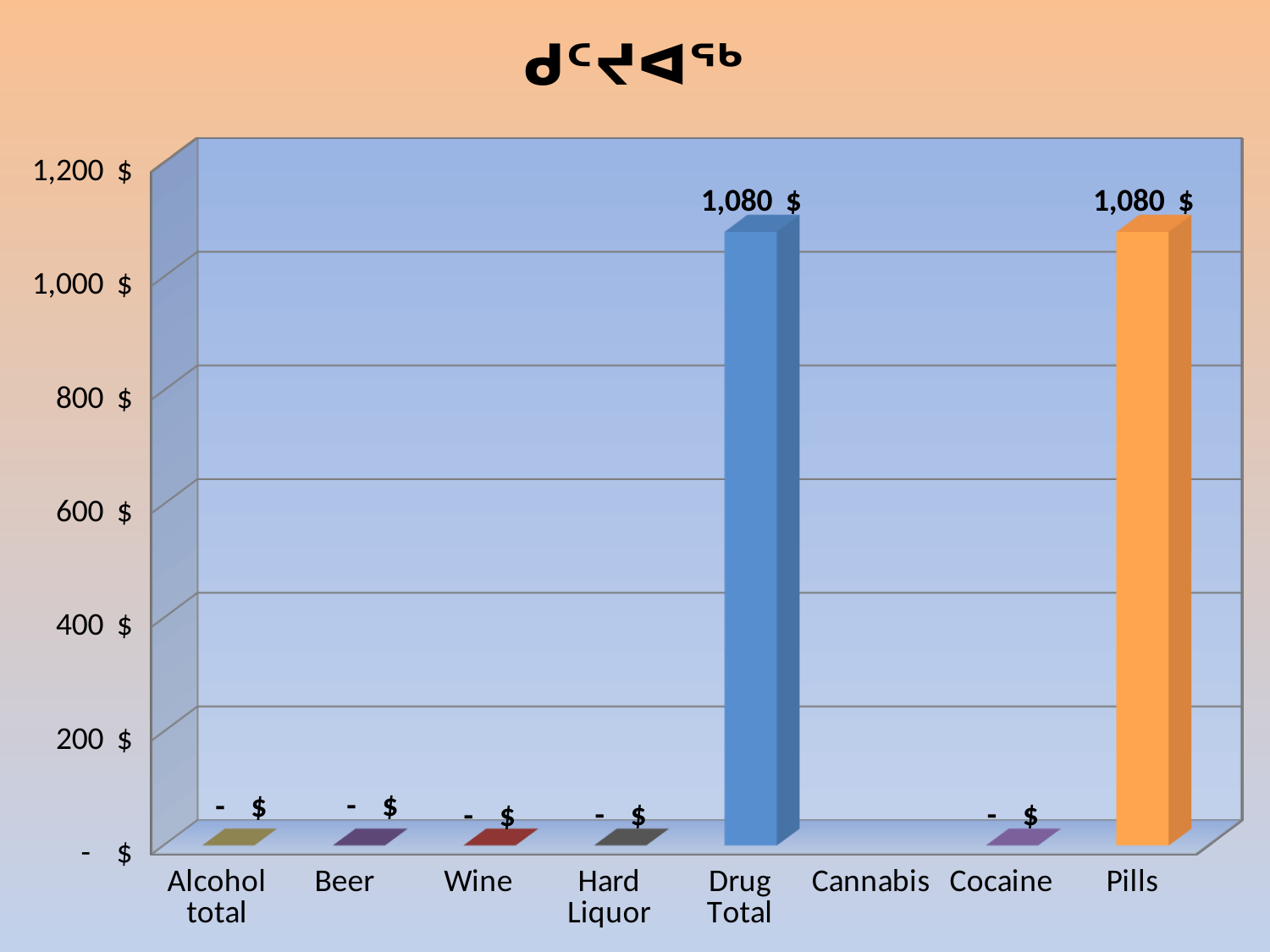
Which is larger, the value for Pills or the value for Beer? Pills What colour is the bar for Pills? orange What is the value shown for Pills? 1,080 $ Which two categories share the highest value on the chart? Drug Total and Pills What value label is shown for Cocaine? - $ What is the difference between the values for Drug Total and Pills? 0 $ What kind of chart is shown on the slide? bar chart Is the value for Drug Total greater or less than 1,000 $? greater What is the value shown for Drug Total? 1,080 $ How many categories are labelled on the x axis? 8 How many categories have a value of 1,080 $? 2 What value label is shown for Alcohol total? - $